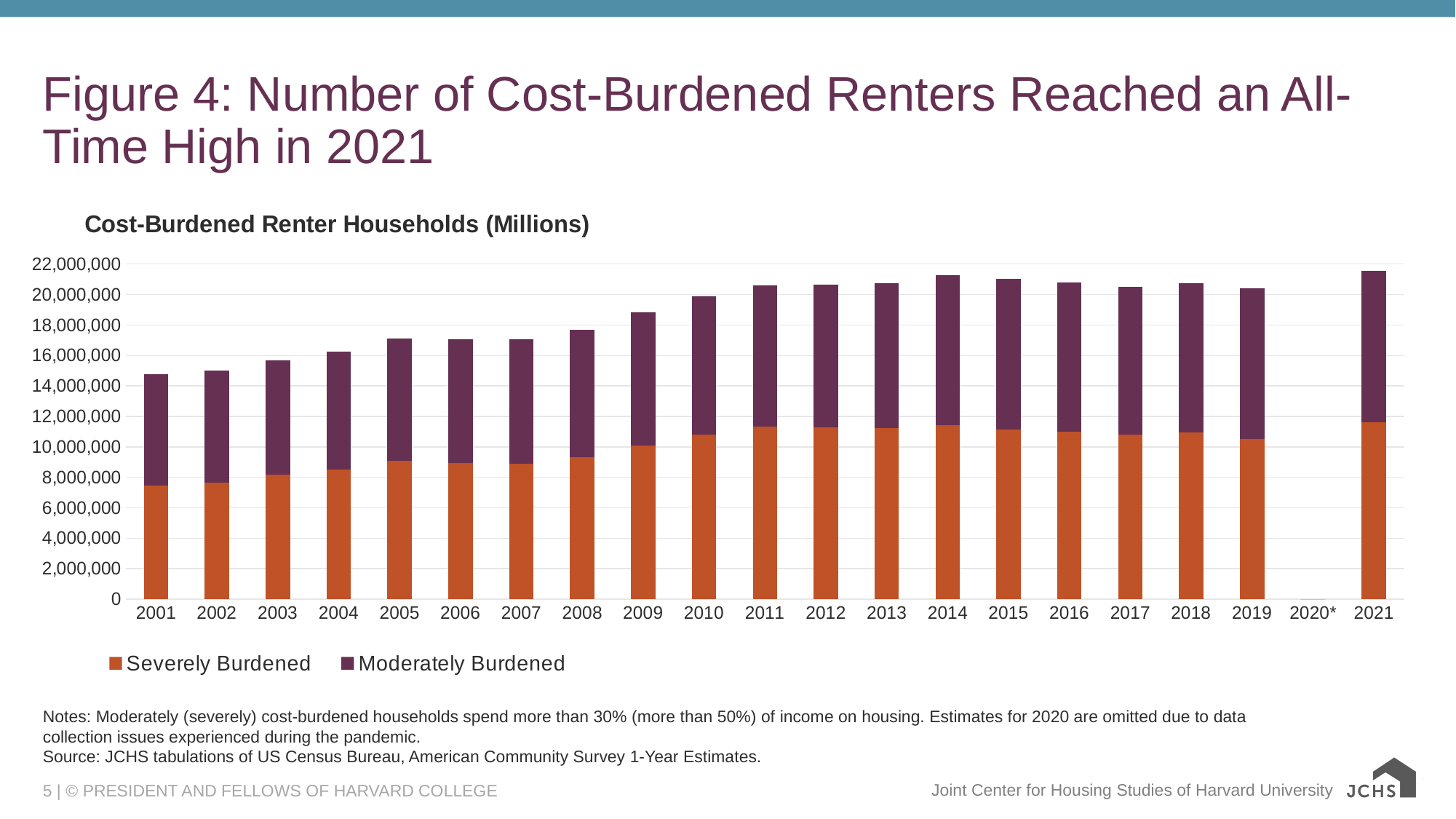
Which year has the lowest total number of cost-burdened renter households? 2001 What are the two series named in the legend? Severely Burdened and Moderately Burdened Is the total for 2001 greater or less than 16,000,000? less Is the Severely Burdened value for 2021 greater or less than 10,000,000? greater Do the total bar heights generally rise or fall from 2001 to 2014? Rise Which year has a larger total of cost-burdened renter households, 2004 or 2005? 2005 Is the Severely Burdened value for 2001 greater or less than 8,000,000? less How many series does the legend list? 2 What is the title of the chart? Cost-Burdened Renter Households (Millions) What kind of chart is shown on the slide? Stacked bar chart Which year has the highest total number of cost-burdened renter households? 2021